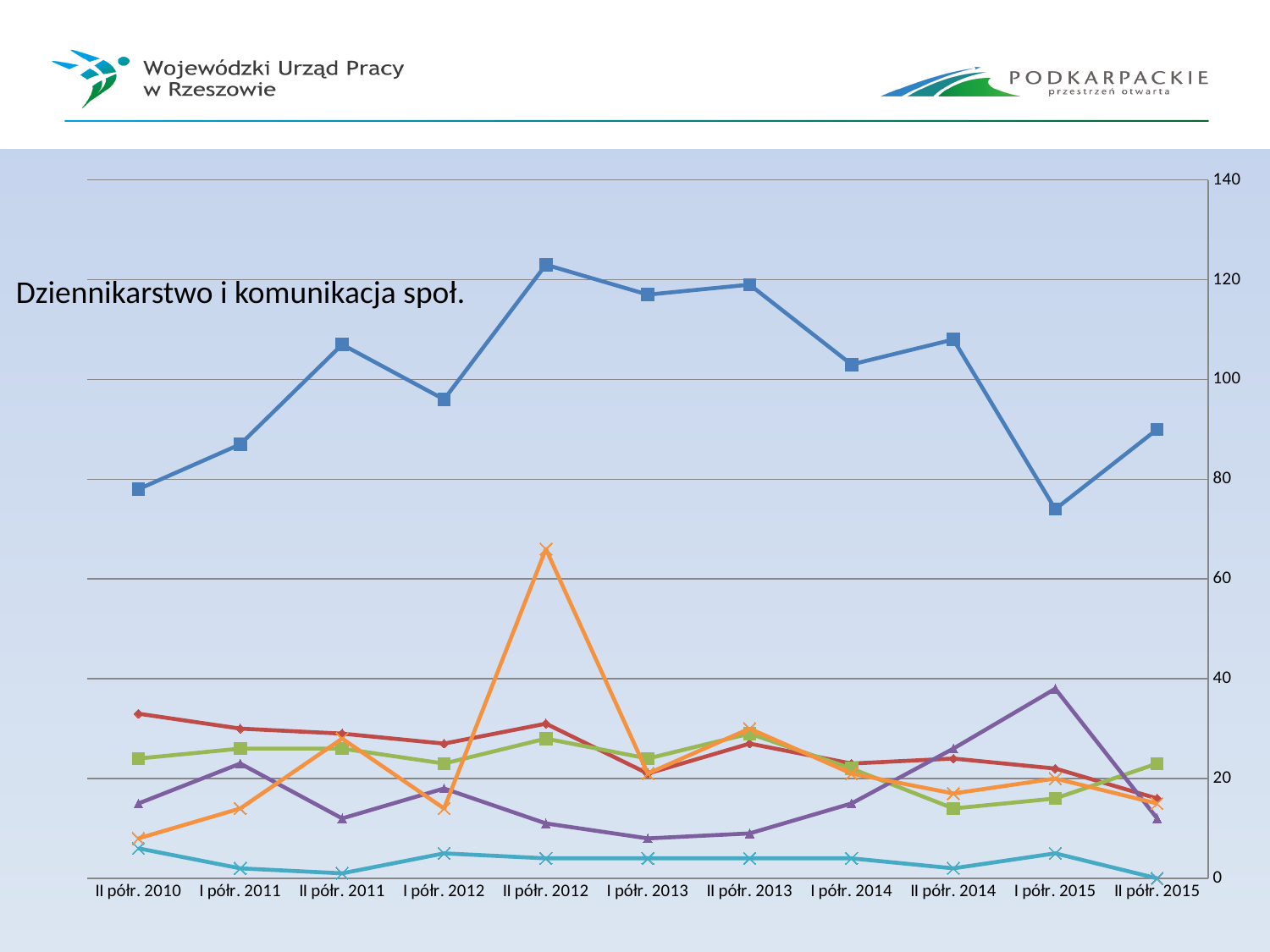
In which period does the orange line reach its highest value? II półr. 2012 Does the top (blue) line rise or fall from II półr. 2010 to II półr. 2011? rise In which period does the top (blue) line reach its highest value? II półr. 2012 What kind of chart is shown on the slide? line chart In which period does the top (blue) line reach its lowest value? I półr. 2015 What is the title shown on the chart? Dziennikarstwo i komunikacja społ. Is the value of the top (blue) line for II półr. 2012 greater or less than 120? greater Is the value of the top (blue) line for II półr. 2014 greater or less than 100? greater Is the value of the orange line for II półr. 2012 greater or less than 60? greater How many lines are plotted on the chart? 6 How many periods (categories) are shown on the x axis? 11